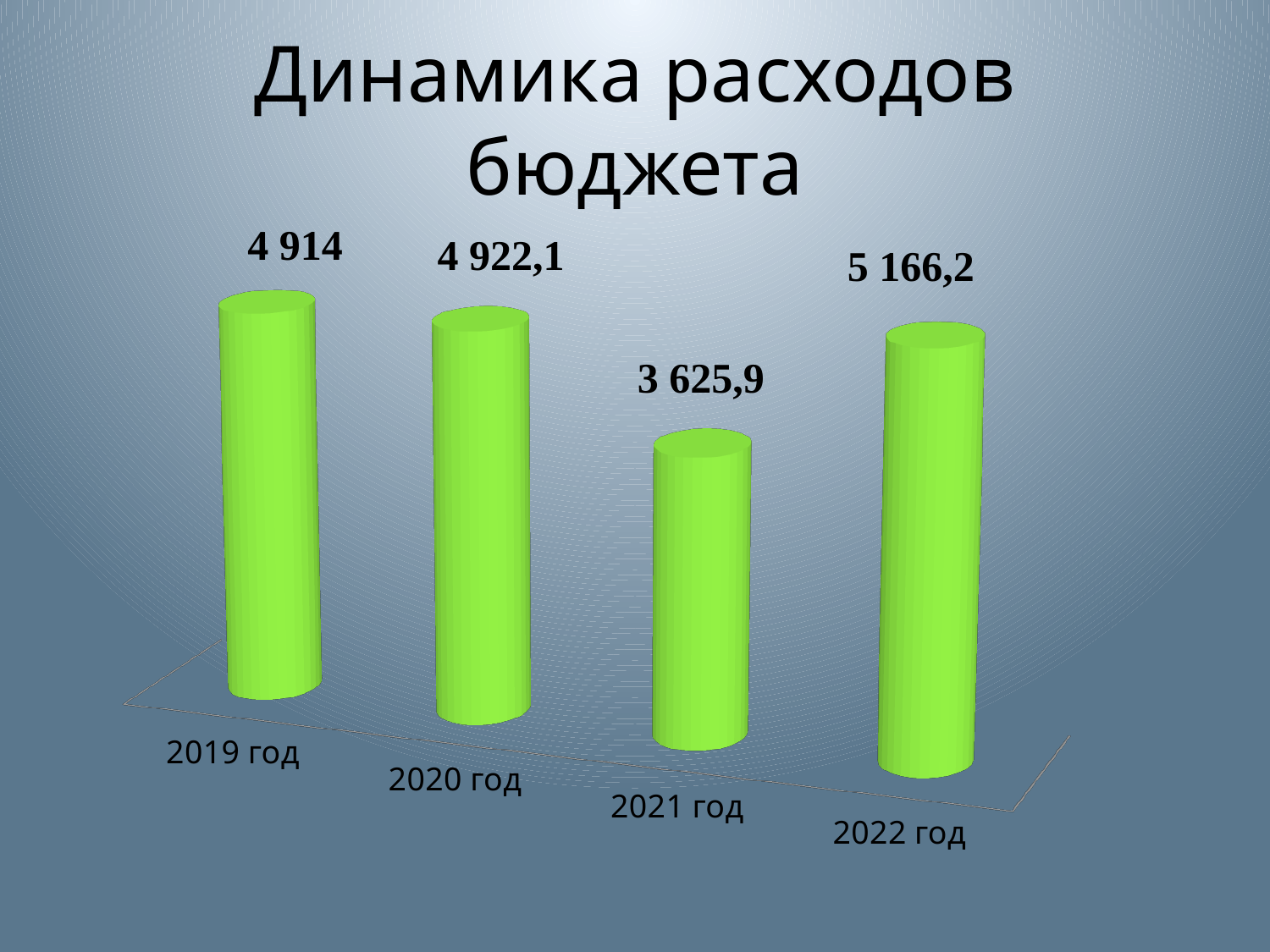
What is the difference between the values for 2022 год and 2020 год? 244,1 What is the value for 2020 год? 4 922,1 What is the value for 2021 год? 3 625,9 What is the value for 2022 год? 5 166,2 What is the title of the chart? Динамика расходов бюджета Which year has the lowest value? 2021 год What is the value for 2019 год? 4 914 Which year has the highest value? 2022 год Which is larger, the value for 2019 год or the value for 2021 год? 2019 год What is the difference between the values for 2022 год and 2021 год? 1 540,3 How many years are shown on the chart? 4 What kind of chart is shown on the slide? bar chart